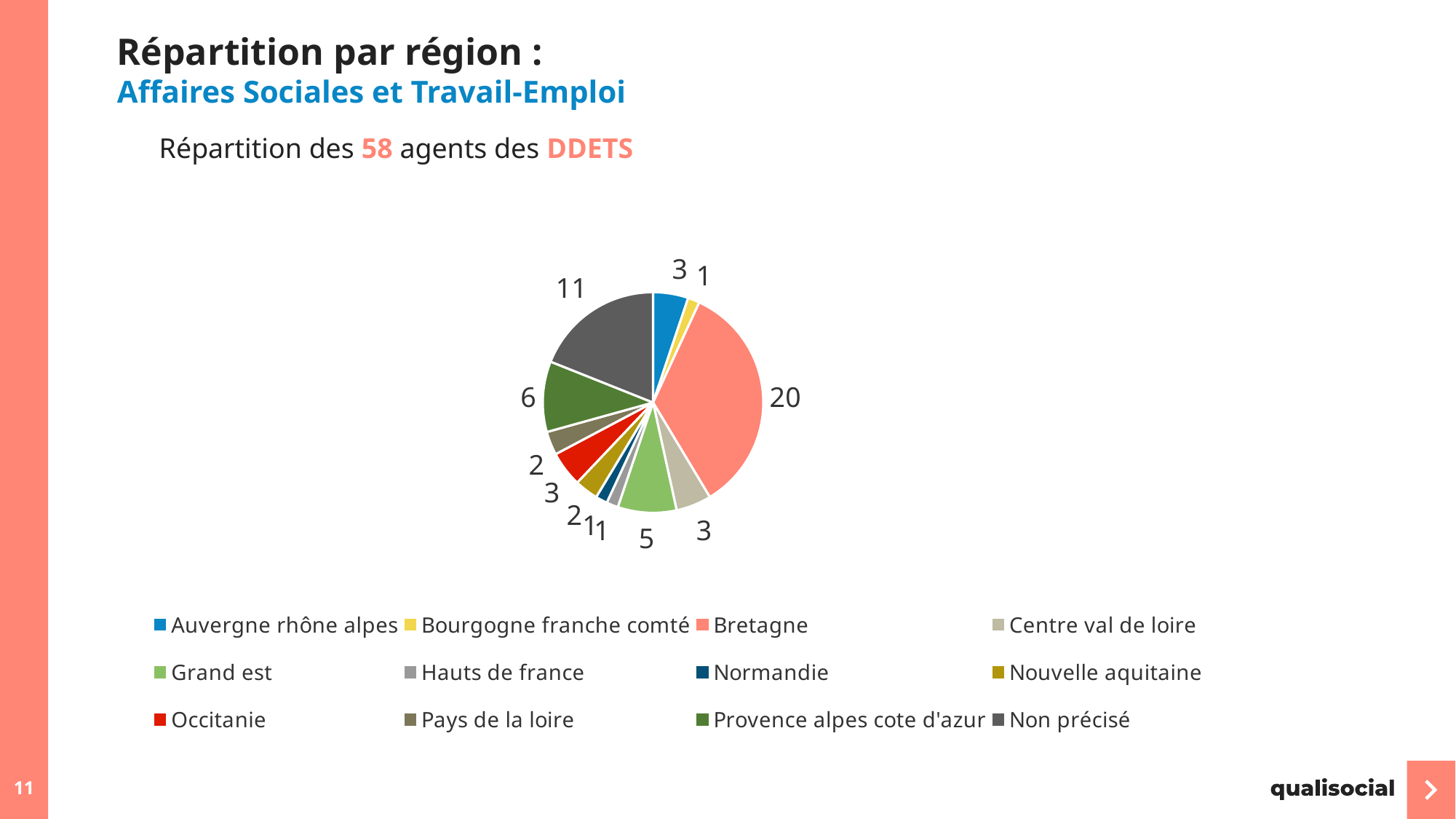
What is the total number of agents represented in the pie chart, according to the slide text? 58 How many agents are shown for Provence alpes cote d'azur? 6 Which legend entry is shown in red? Occitanie What is the difference between the values for Bretagne and Non précisé? 9 Which region has the largest slice of the pie chart? Bretagne Which is larger, the value for Provence alpes cote d'azur or the value for Grand est? Provence alpes cote d'azur What is the value shown for Auvergne rhône alpes? 3 What type of chart is shown on the slide? Pie chart What is the value shown for Non précisé in the pie chart? 11 What is the value for Grand est in the pie chart? 5 How many agents does the pie chart show for Bretagne? 20 How many categories does the pie chart have? 12